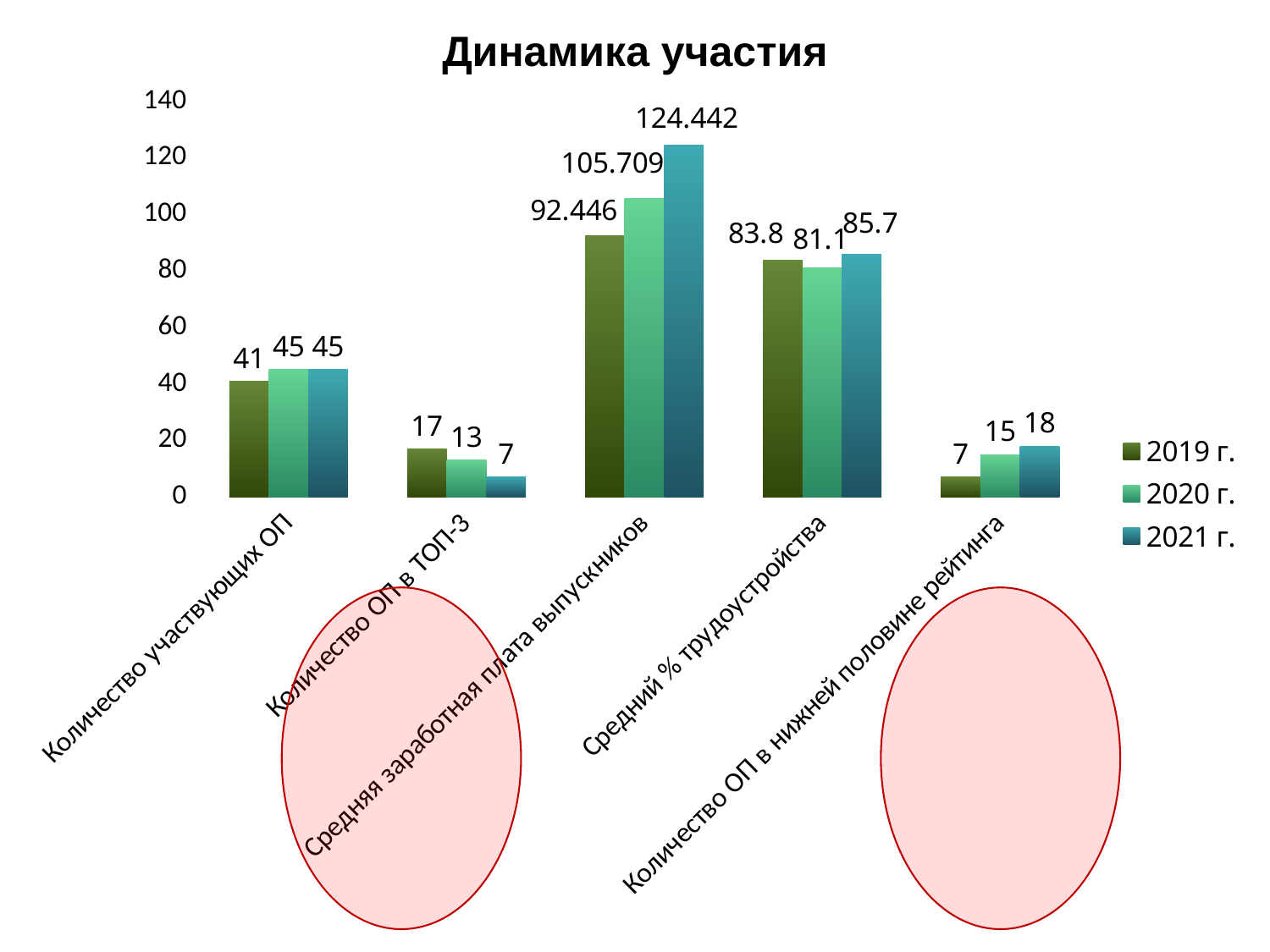
What is the value for 2020 г. in the category 'Средний % трудоустройства'? 81.1 How many series does the legend list? 3 What is the value for 2021 г. in the category 'Средняя заработная плата выпускников'? 124.442 Which is larger in the category 'Средний % трудоустройства': the value for 2019 г. or for 2021 г.? 2021 г. What is the value for 2019 г. in the category 'Количество ОП в ТОП-3'? 17 How many categories are shown on the x axis? 5 What is the title of the chart? Динамика участия What is the difference between the 2021 г. and 2019 г. values in the category 'Количество участвующих ОП'? 4 Do the values for 'Средняя заработная плата выпускников' rise or fall from 2019 г. to 2021 г.? rise What kind of chart is shown on the slide? bar chart Which year has the highest value in the category 'Количество ОП в нижней половине рейтинга'? 2021 г. Which year has the lowest value in the category 'Количество ОП в ТОП-3'? 2021 г.